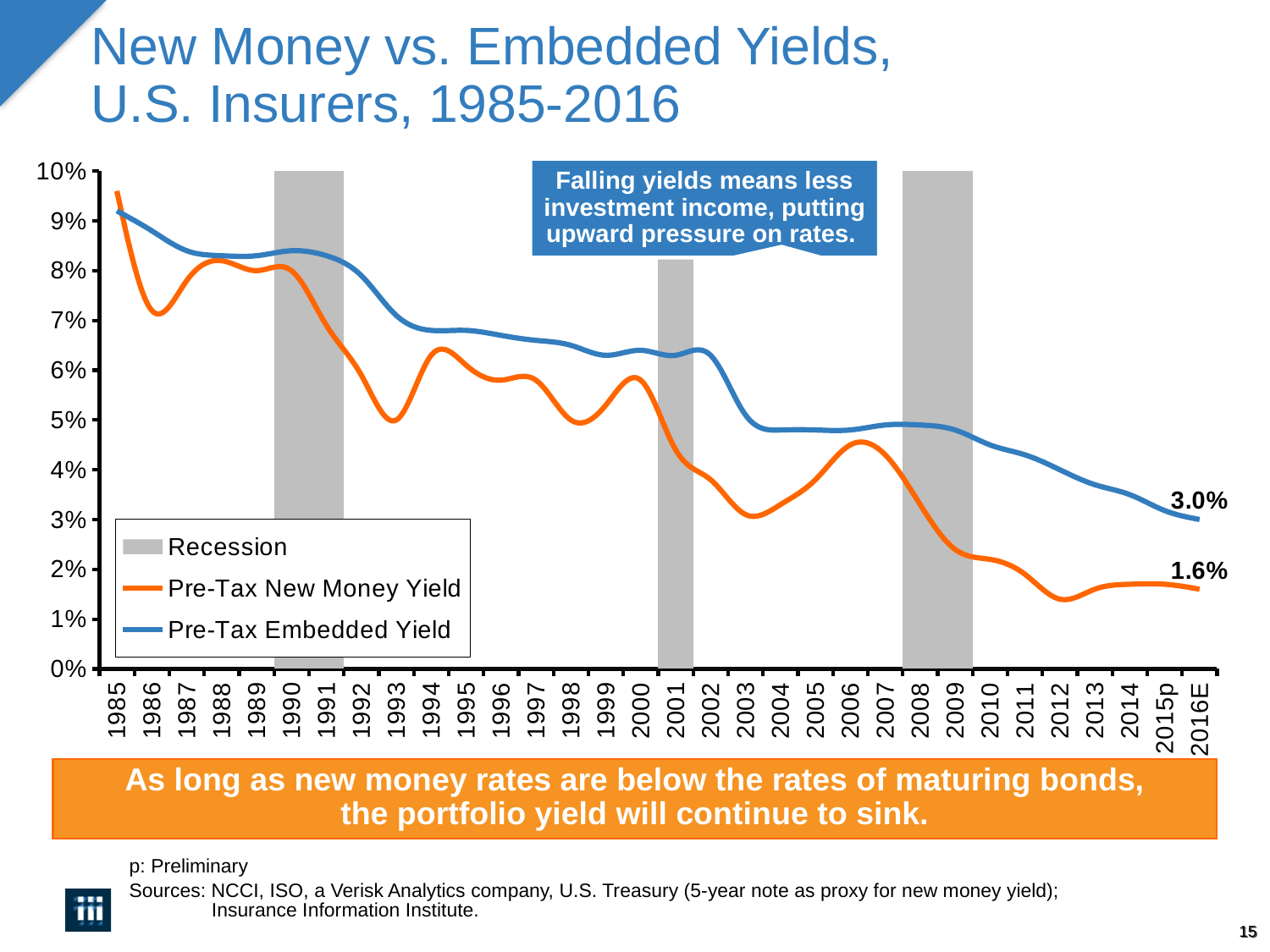
Is the Pre-Tax New Money Yield in 2003 greater or less than 4%? less How many years are shown on the x axis of the chart? 32 Is the Pre-Tax Embedded Yield in 2010 greater or less than 4%? greater In 2016E, which is larger: the Pre-Tax Embedded Yield or the Pre-Tax New Money Yield? Pre-Tax Embedded Yield Is the Pre-Tax New Money Yield in 1985 greater or less than 9%? greater What is the Pre-Tax New Money Yield value labeled for 2016E? 1.6% What is the Pre-Tax Embedded Yield value labeled for 2016E? 3.0% What kind of chart is shown on the slide? Line chart How many entries does the chart's legend list? 3 What is the difference between the Pre-Tax Embedded Yield and the Pre-Tax New Money Yield in 2016E? 1.4 percentage points Does the Pre-Tax Embedded Yield generally rise or fall from 1985 to 2016E? Fall